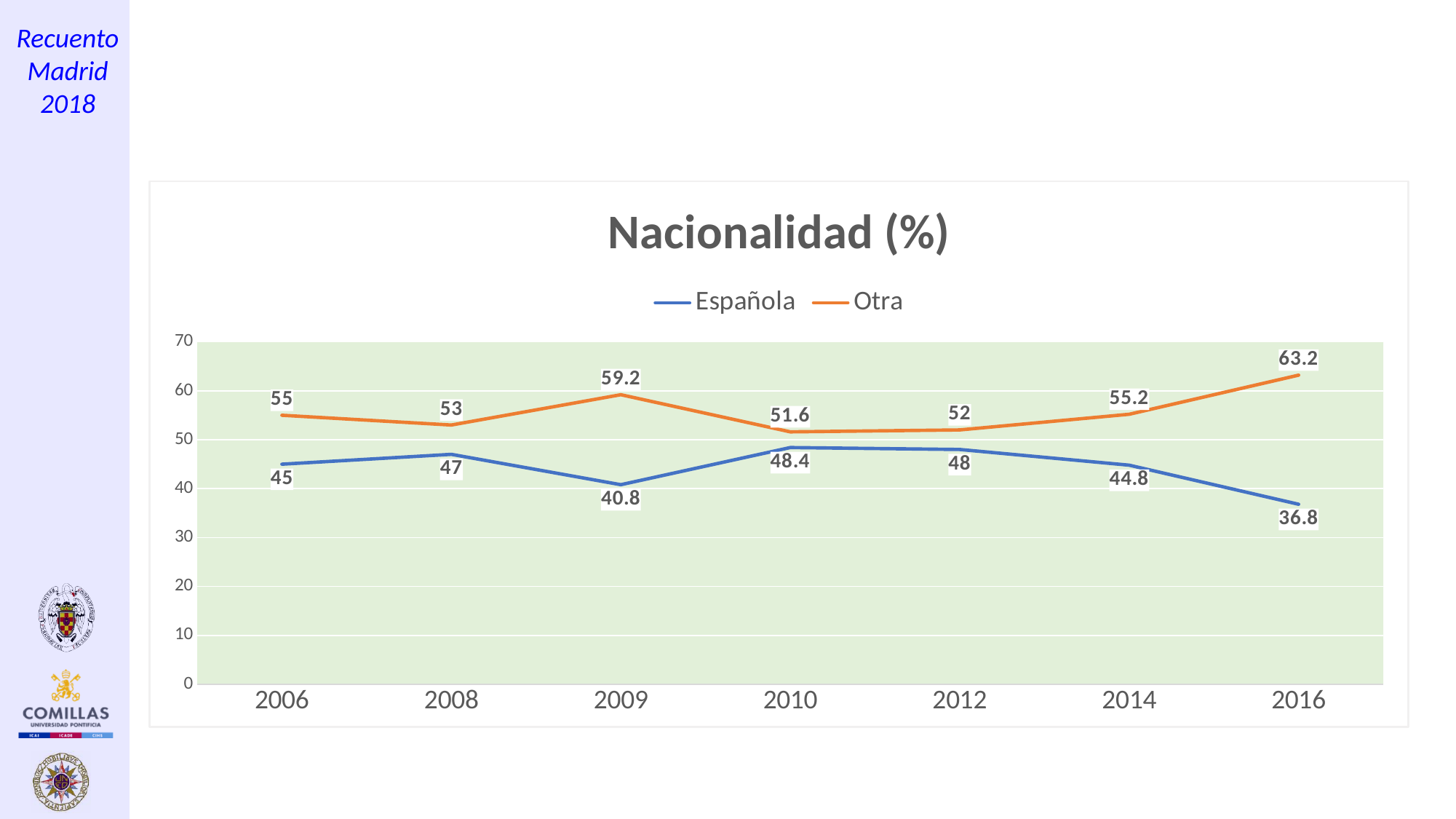
What is the title of the chart? Nacionalidad (%) What is the difference between Otra and Española in 2016? 26.4 Which is larger in 2012, Española or Otra? Otra In which year is the Española series lowest? 2016 Is the value for Española in 2014 greater or less than 50? less What is the value for Otra in 2016? 63.2 How many series does the legend list? 2 What kind of chart is shown? line chart In which year is the Otra series highest? 2016 How many years are shown on the x axis? 7 What is the value for Española in 2009? 40.8 What is the value for Otra in 2010? 51.6